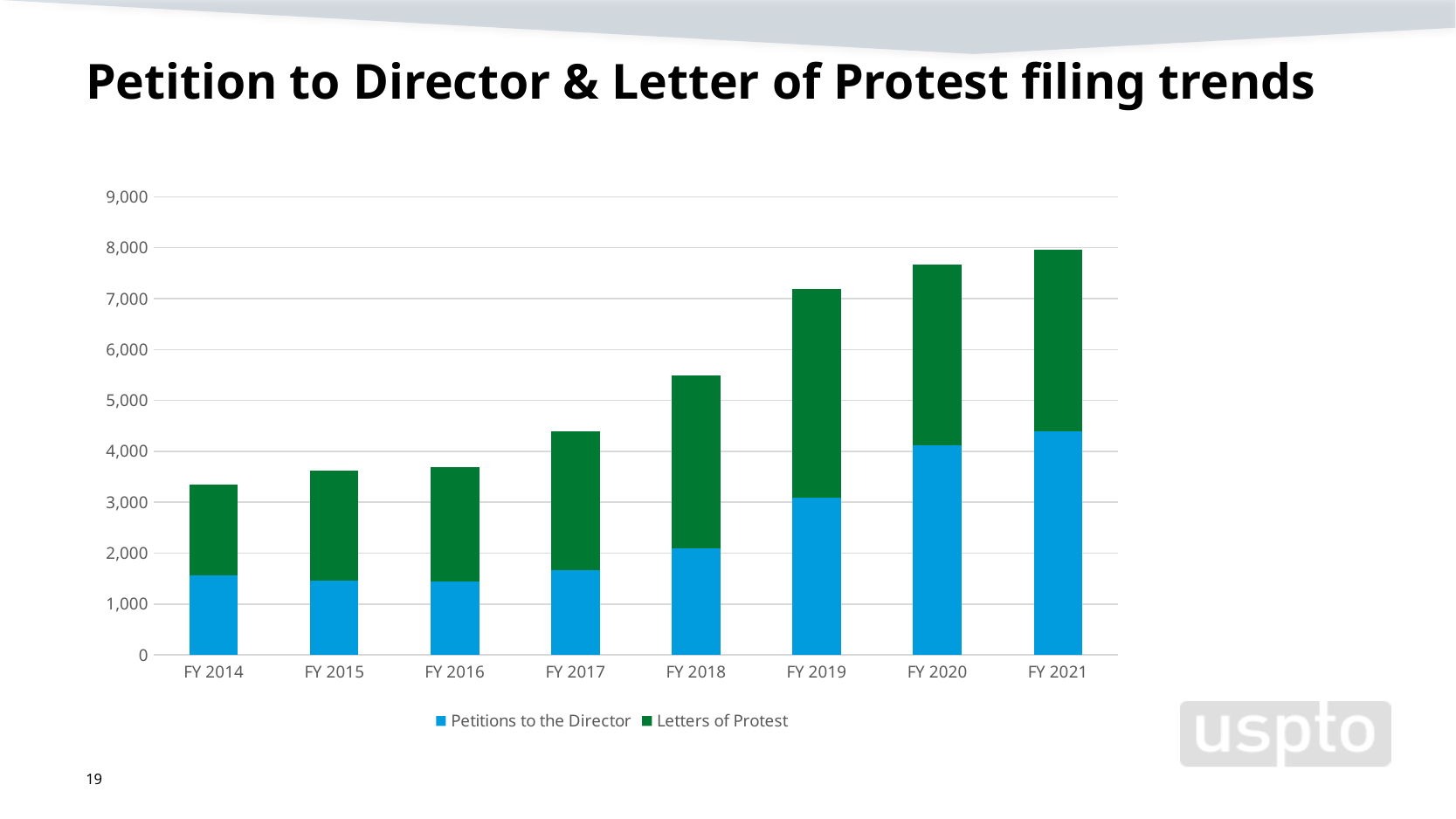
How many series does the legend list? 2 Which has the larger total stacked bar, FY 2018 or FY 2019? FY 2019 Is the Petitions to the Director value for FY 2018 greater or less than 3,000? less Is the total stacked bar for FY 2021 greater or less than 7,000? greater How many fiscal years are shown on the x axis? 8 Which fiscal year has the shortest stacked bar? FY 2014 Which fiscal year has the tallest stacked bar? FY 2021 What kind of chart is shown on the slide? Stacked bar chart Do the total stacked bar heights rise or fall from FY 2014 to FY 2021? rise Is the Petitions to the Director value for FY 2021 greater or less than 4,000? greater What are the two series named in the legend? Petitions to the Director and Letters of Protest